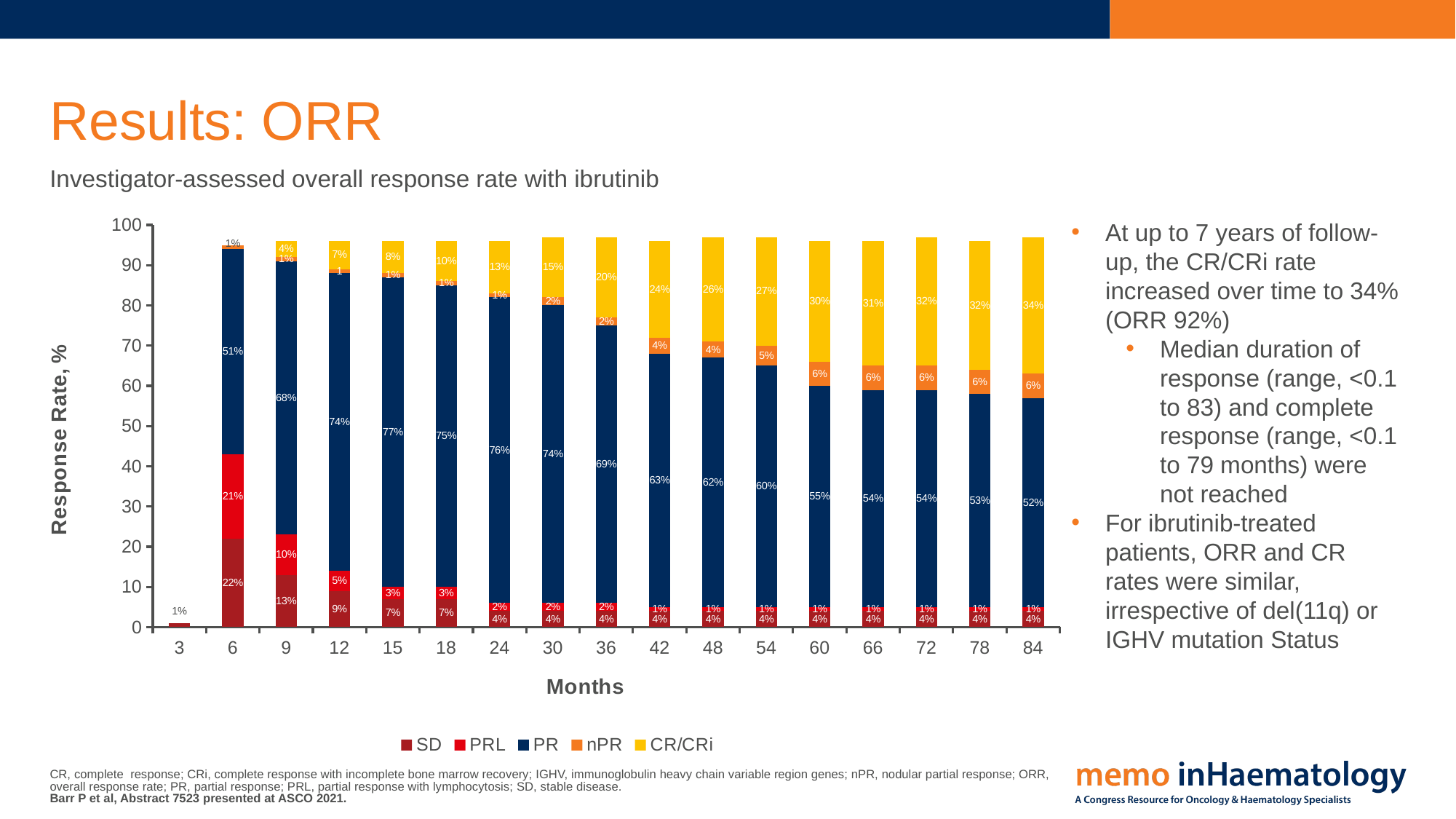
How many series does the legend list? 5 At which month is the SD value highest? 6 Does the CR/CRi value rise or fall from 9 months to 84 months? Rise What is the PRL value at 6 months? 21% What is the total of the stacked bar at 84 months? 97% What is the PR value at 15 months? 77% At which month is the CR/CRi value highest? 84 What is the difference between the CR/CRi value at 84 months and at 42 months? 10% How many month categories are shown on the x axis? 17 What kind of chart is shown? Stacked bar chart Which has the larger PR value, 12 months or 36 months? 12 months What is the CR/CRi value at 84 months? 34%